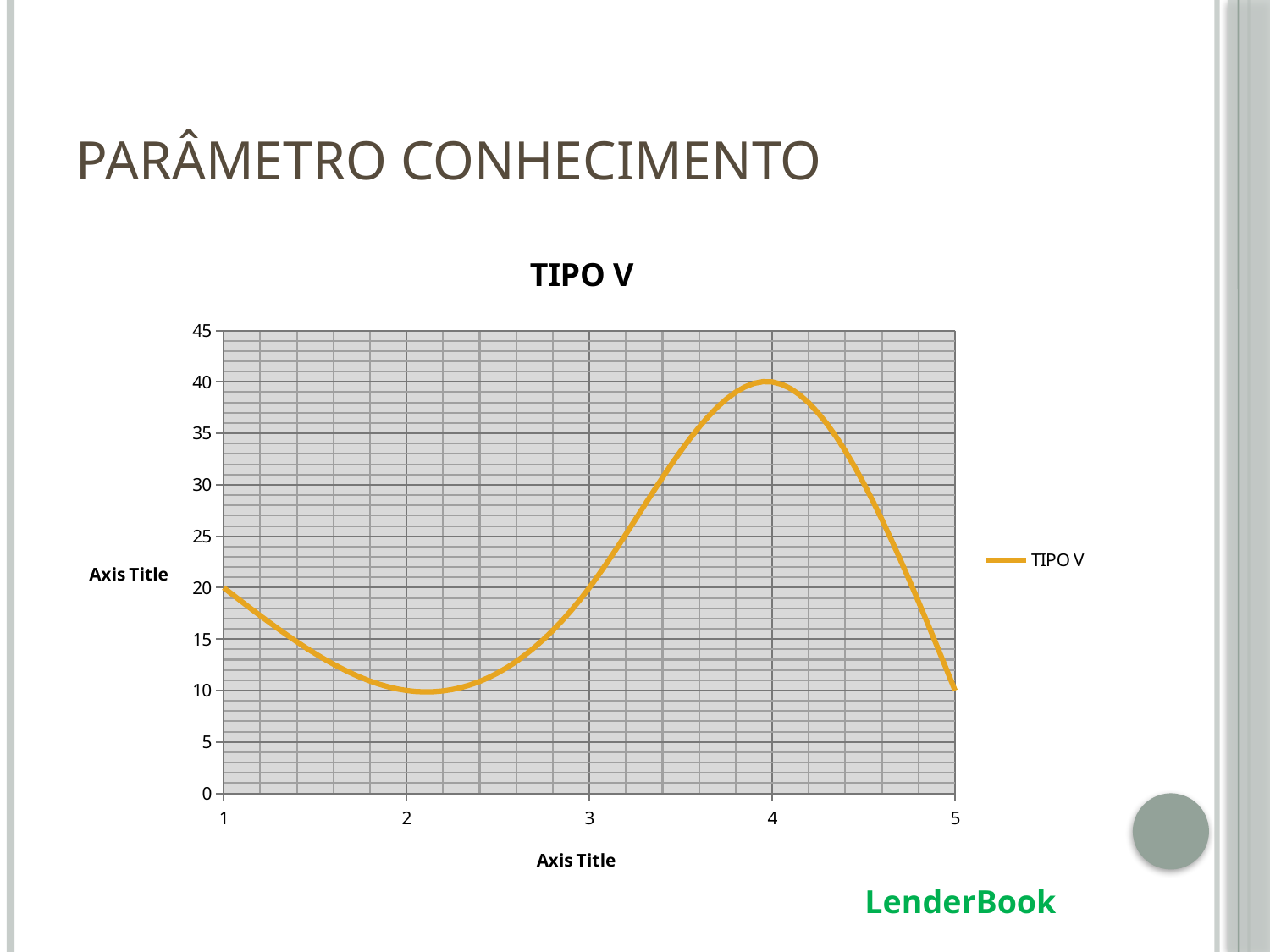
Is the value of TIPO V at x = 3 greater or less than 15? greater How many points are plotted along the x axis? 5 What is the value of TIPO V at x = 4? 40 What is the value of TIPO V at x = 5? 10 Which is larger, the value of TIPO V at x = 1 or at x = 5? x = 1 At which x value does TIPO V reach its highest value? 4 What kind of chart is shown on the slide? line chart What is the title of the chart? TIPO V What is the value of TIPO V at x = 1? 20 How many series does the legend list? 1 Is the value of TIPO V at x = 2 greater or less than 15? less Does the value of TIPO V rise or fall between x = 4 and x = 5? fall